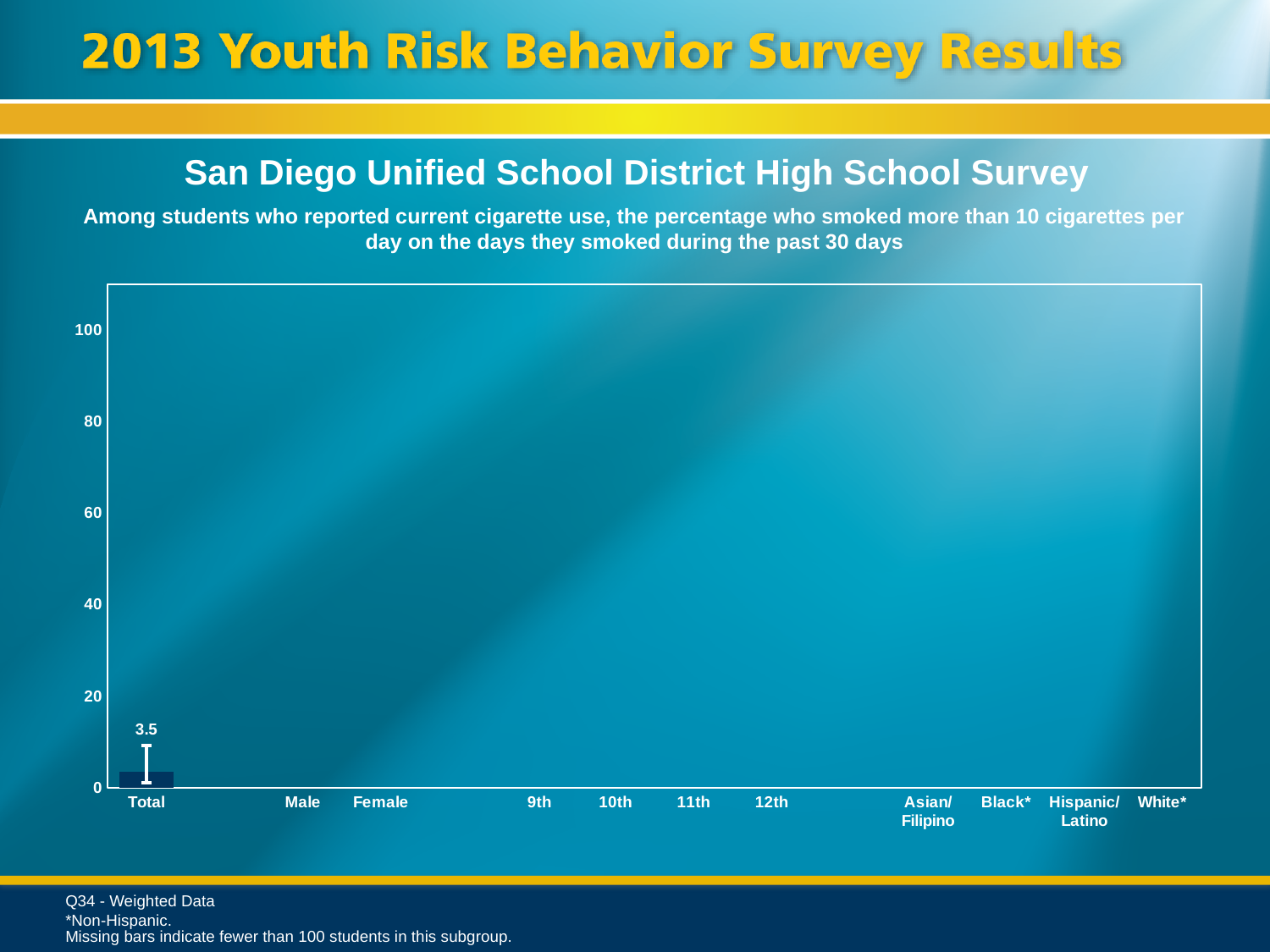
What is the value shown for the Total category? 3.5 What is the highest tick value shown on the y axis? 100 What kind of chart is shown on the slide? bar chart How many bars are actually plotted on the chart? 1 Which category is the only one with a plotted bar? Total Is the value for Total greater or less than 20? less How many category labels are shown along the x axis? 11 According to the footnote, what do missing bars indicate? Fewer than 100 students in this subgroup